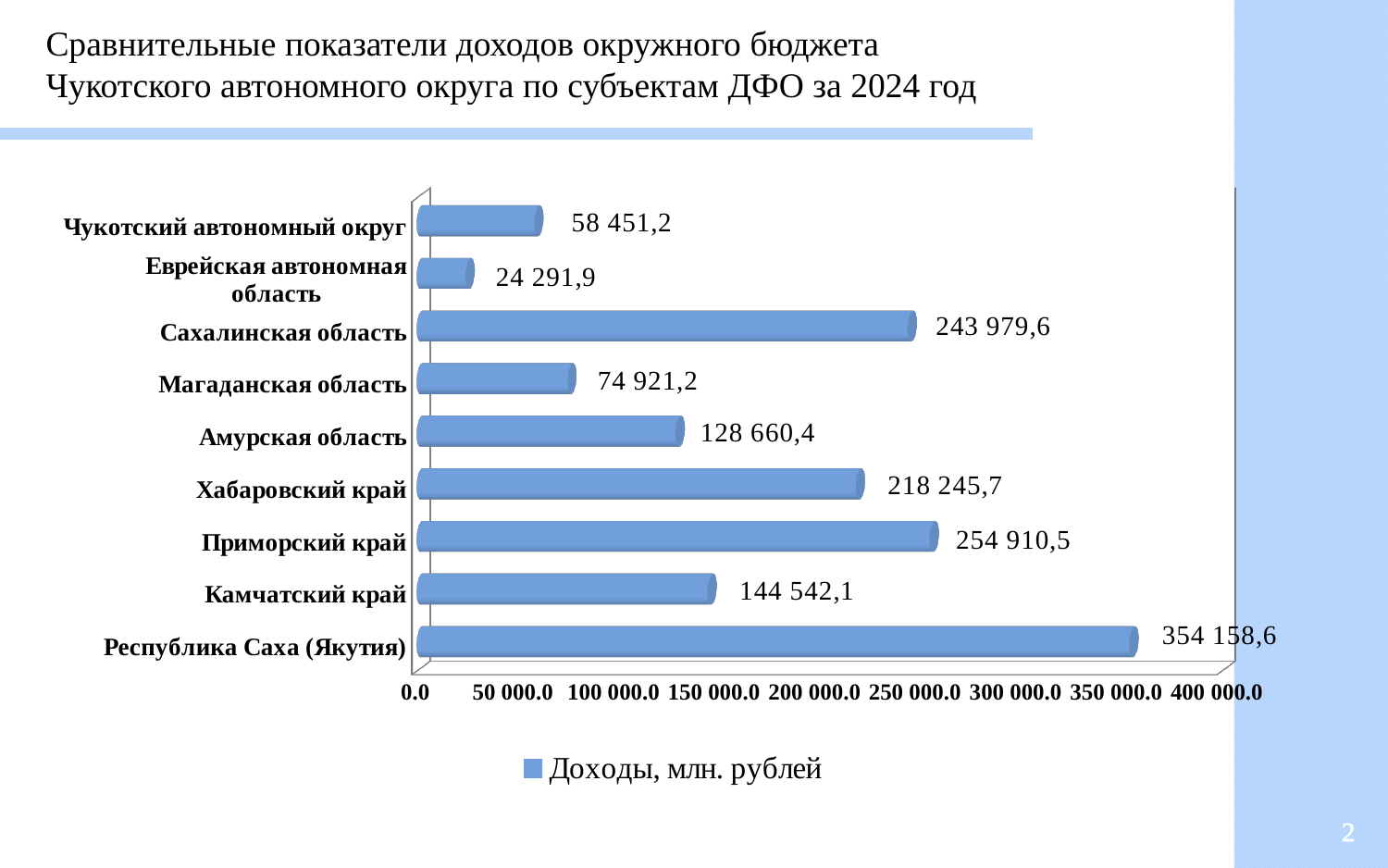
What is the value for Чукотский автономный округ? 58 451,2 What kind of chart is shown on the slide? Bar chart What is the value for Сахалинская область? 243 979,6 How many regions are shown in the chart? 9 What is the legend entry of the chart? Доходы, млн. рублей What is the value for Хабаровский край? 218 245,7 Which region has the highest value? Республика Саха (Якутия) Which region has the lowest value? Еврейская автономная область What is the difference between the values for Чукотский автономный округ and Еврейская автономная область? 34 159,3 Which is larger, the value for Амурская область or the value for Магаданская область? Амурская область What is the difference between the values for Приморский край and Сахалинская область? 10 930,9 What is the value for Камчатский край? 144 542,1